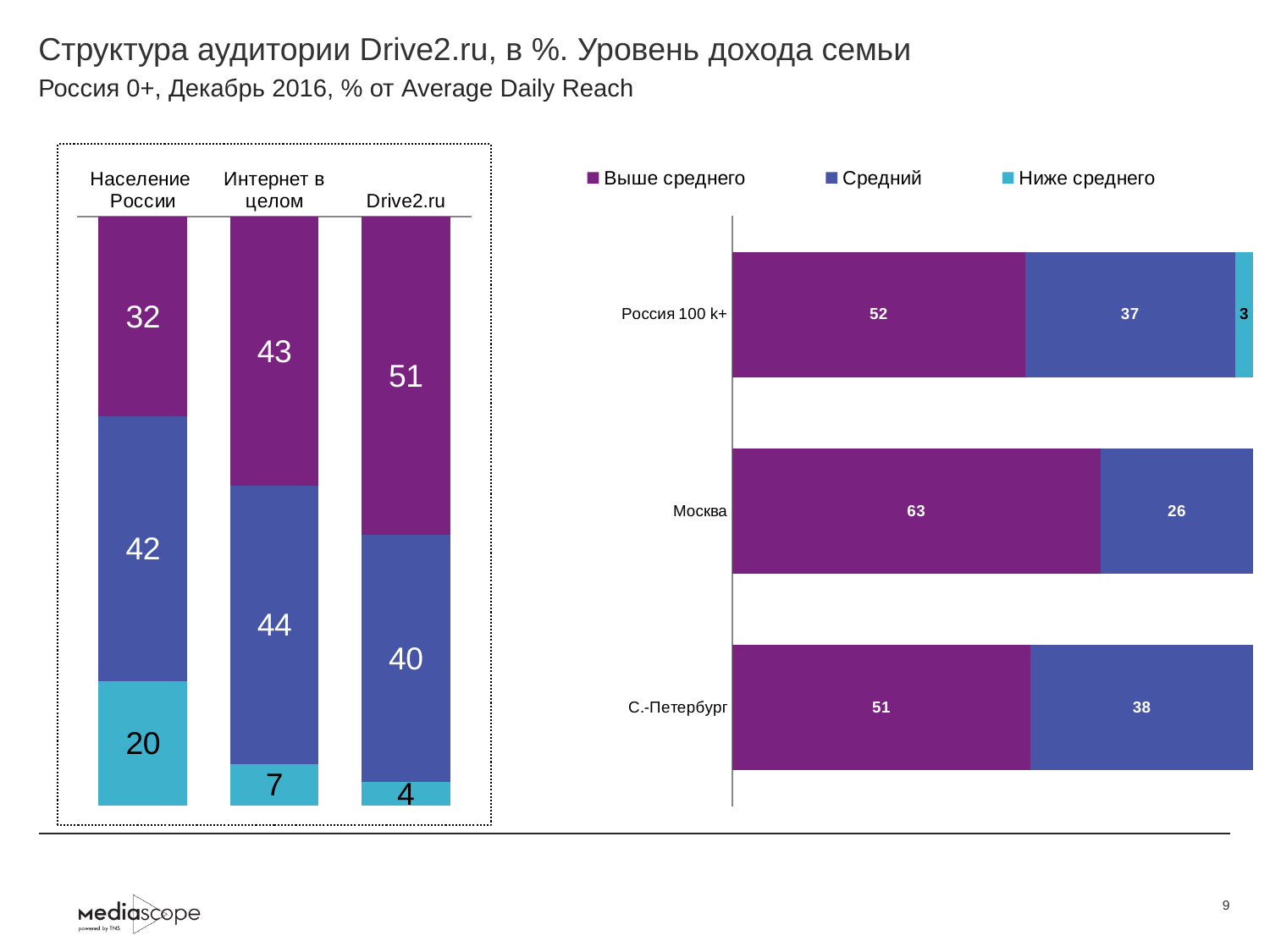
In the left chart, what is the value of the 'Средний' segment for Интернет в целом? 44 In the left chart, what is the value of the 'Выше среднего' segment for Drive2.ru? 51 In the right chart, what is the total of the stacked bar for Россия 100 k+? 92 In the left chart, what is the difference between the 'Выше среднего' values for Drive2.ru and Население России? 19 In the right chart, what is the 'Средний' value for С.-Петербург? 38 In the left chart, what is the value of the 'Ниже среднего' segment for Население России? 20 In the left chart, which category has the highest 'Выше среднего' value? Drive2.ru In the left chart, what is the total of the stacked bar for Население России? 94 How many series does the legend of the right chart list? 3 In the left chart, which category has the lowest 'Ниже среднего' value? Drive2.ru In the right chart, which city or region has the highest 'Выше среднего' value? Москва In the right chart, what is the 'Выше среднего' value for Москва? 63